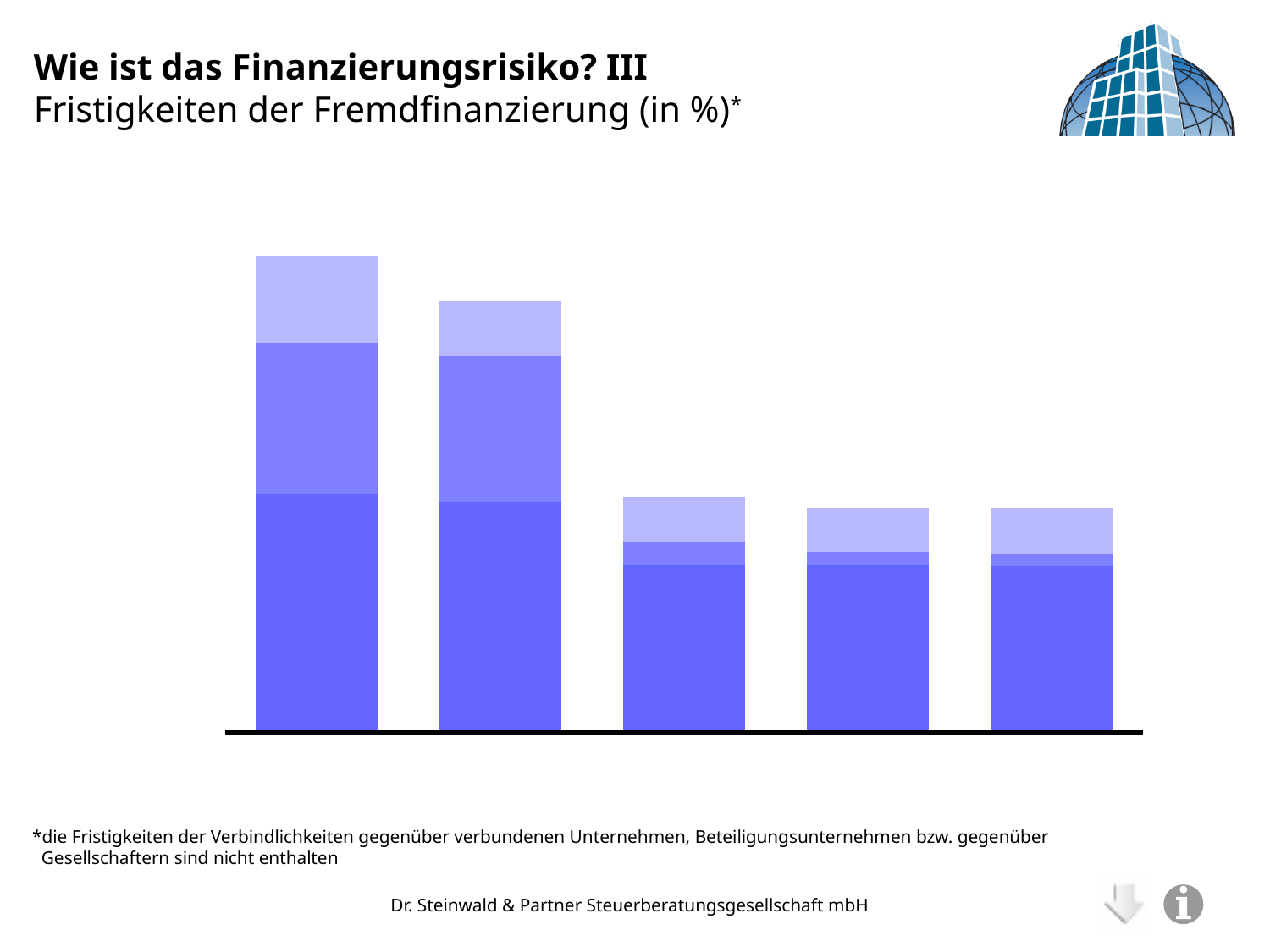
What is the subtitle of the chart on the slide? Fristigkeiten der Fremdfinanzierung (in %)* How many bars are plotted in the chart? 5 Do the total bar heights generally rise or fall from left to right? Fall Is the second bar from the left taller or shorter than the third bar? Taller What kind of chart is shown on the slide? Stacked bar chart Is the first bar from the left taller or shorter than the second bar? Taller How many stacked segments does each bar contain? 3 Which segment is the largest in every bar: the bottom, middle or top one? The bottom one Which bar is the tallest in the chart? The first (leftmost) bar